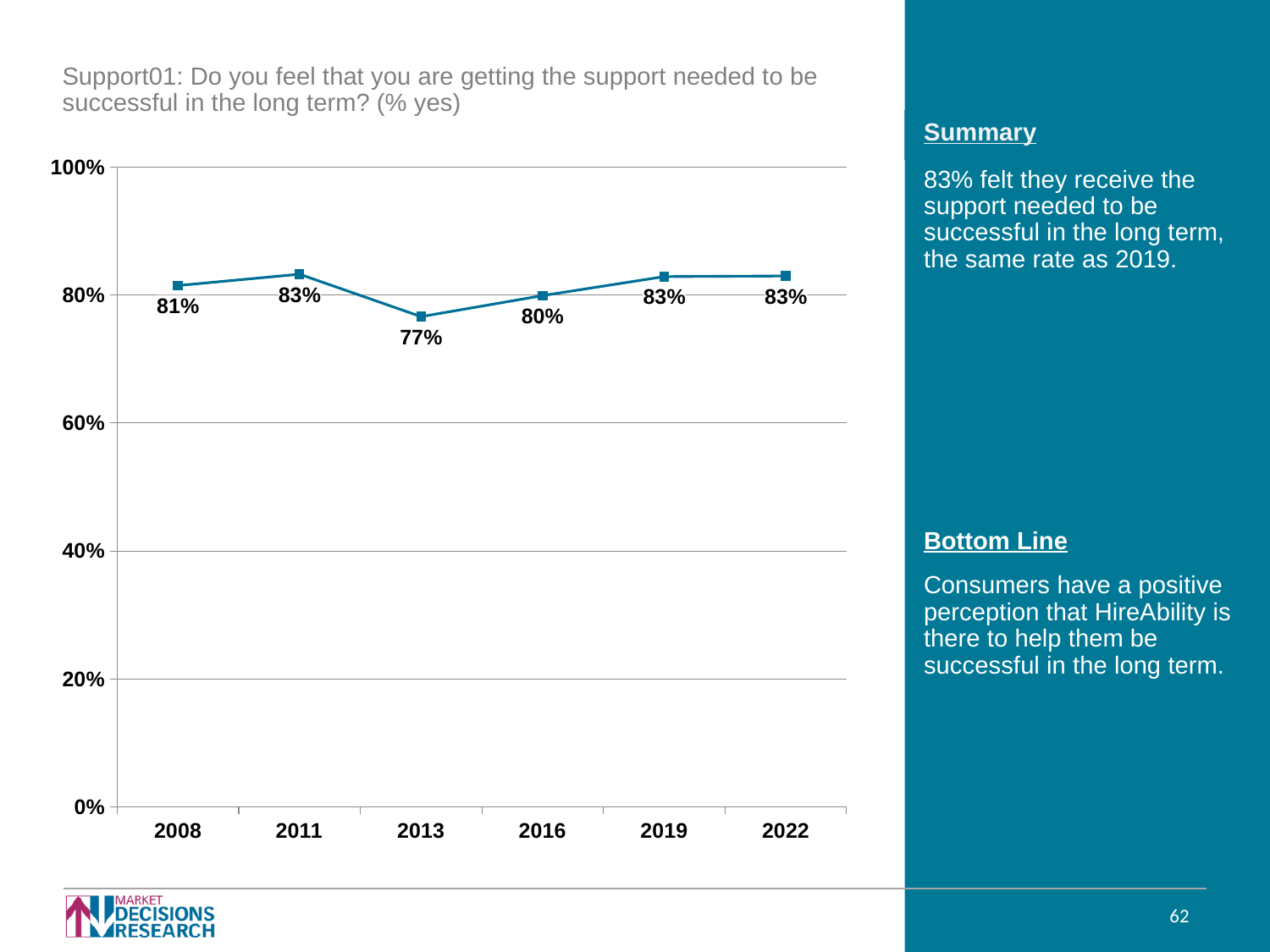
What kind of chart is shown on the slide? Line chart What is the highest value shown on the y axis? 100% Is the value for 2013 greater or less than 80%? less What was the value for 2008? 81% Did the value rise or fall from 2013 to 2016? Rise What is the difference between the 2016 value and the 2008 value? 1% How many years are plotted on the chart? 6 Which is larger, the value for 2016 or the value for 2013? 2016 What was the value for 2022? 83% What percentage of respondents said yes in 2013? 77% What is the difference between the 2011 value and the 2013 value? 6% Which year had the lowest percentage of yes responses? 2013